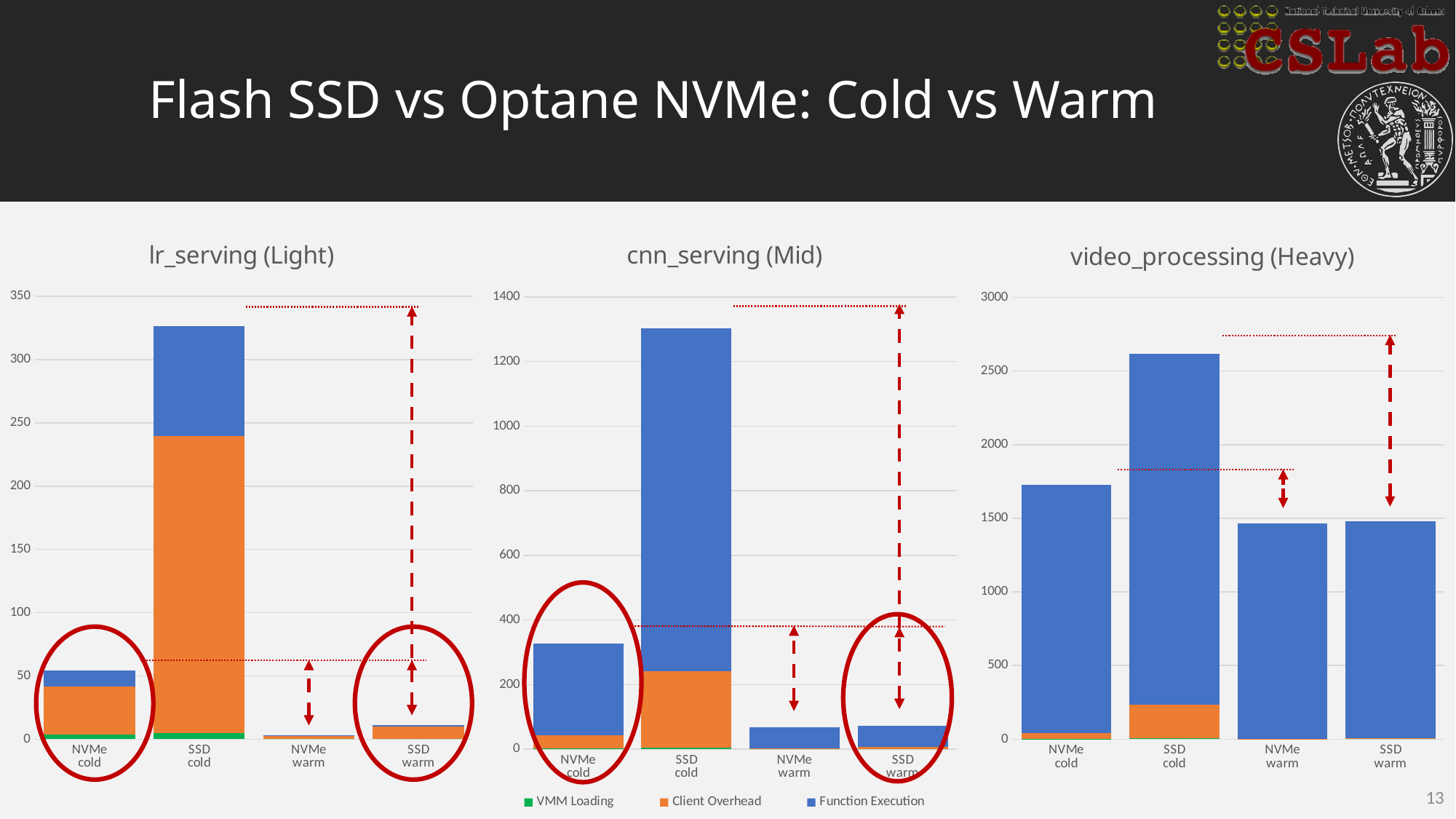
In the video_processing (Heavy) chart, is the total for NVMe cold greater or less than 1500? greater In the lr_serving (Light) chart, how many bars (categories) are plotted? 4 How many series does the legend at the bottom of the slide list? 3 In the cnn_serving (Mid) chart, which is larger, the total for NVMe cold or the total for NVMe warm? NVMe cold In the video_processing (Heavy) chart, which category has the tallest bar? SSD cold In the lr_serving (Light) chart, which category has the tallest bar? SSD cold In the lr_serving (Light) chart, what kind of chart is shown? Stacked bar chart In the cnn_serving (Mid) chart, is the total for SSD cold greater or less than 1200? greater In the lr_serving (Light) chart, which is larger, the total for NVMe cold or the total for SSD warm? NVMe cold In the lr_serving (Light) chart, is the total for SSD cold greater or less than 300? greater In the lr_serving (Light) chart, which category has the shortest bar? NVMe warm In the cnn_serving (Mid) chart, which category has the tallest bar? SSD cold